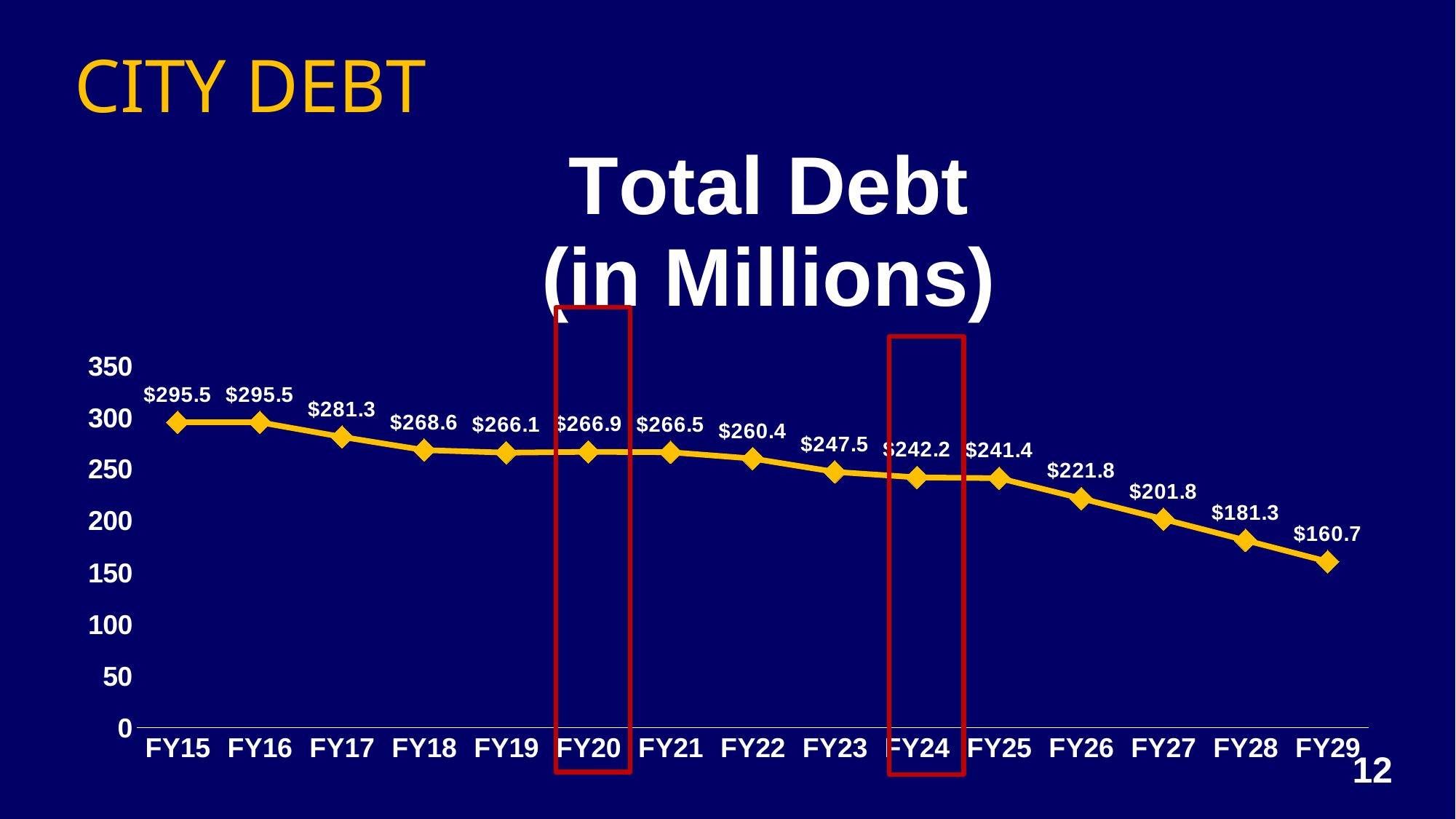
Does the total debt rise or fall from FY15 to FY29? fall What is the total debt for FY20? $266.9 What is the total debt for FY29? $160.7 How many fiscal years are plotted on the chart? 15 What is the difference in total debt between FY15 and FY29? $134.8 Which fiscal year has the lowest total debt? FY29 What is the difference in total debt between FY20 and FY24? $24.7 Which is larger, the total debt for FY22 or for FY26? FY22 What kind of chart is shown on the slide? line chart Is the total debt for FY26 greater or less than 200? greater What is the total debt for FY24? $242.2 What is the title of the chart? Total Debt (in Millions)